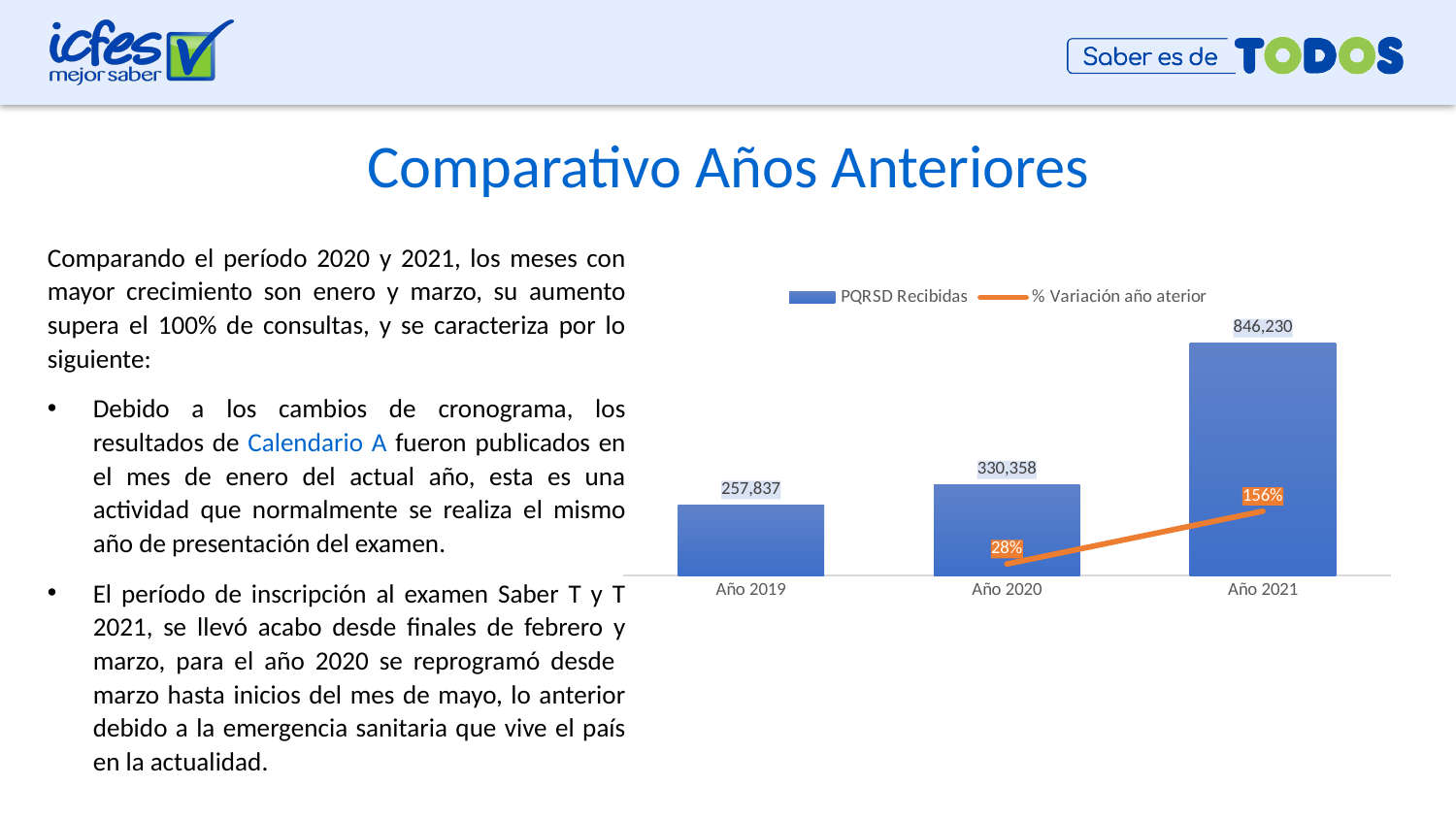
What is the value of PQRSD Recibidas for Año 2020? 330,358 What is the difference in PQRSD Recibidas between Año 2020 and Año 2019? 72,521 Which is larger, the PQRSD Recibidas for Año 2020 or for Año 2019? Año 2020 What is the difference in PQRSD Recibidas between Año 2021 and Año 2020? 515,872 What is the value of PQRSD Recibidas for Año 2019? 257,837 What is the value of PQRSD Recibidas for Año 2021? 846,230 How many years are shown on the x axis of the chart? 3 How many series does the chart legend list? 2 What is the % Variación año aterior value shown for Año 2020? 28% Which year has the highest number of PQRSD Recibidas? Año 2021 Which year has the lowest number of PQRSD Recibidas? Año 2019 What is the % Variación año aterior value shown for Año 2021? 156%